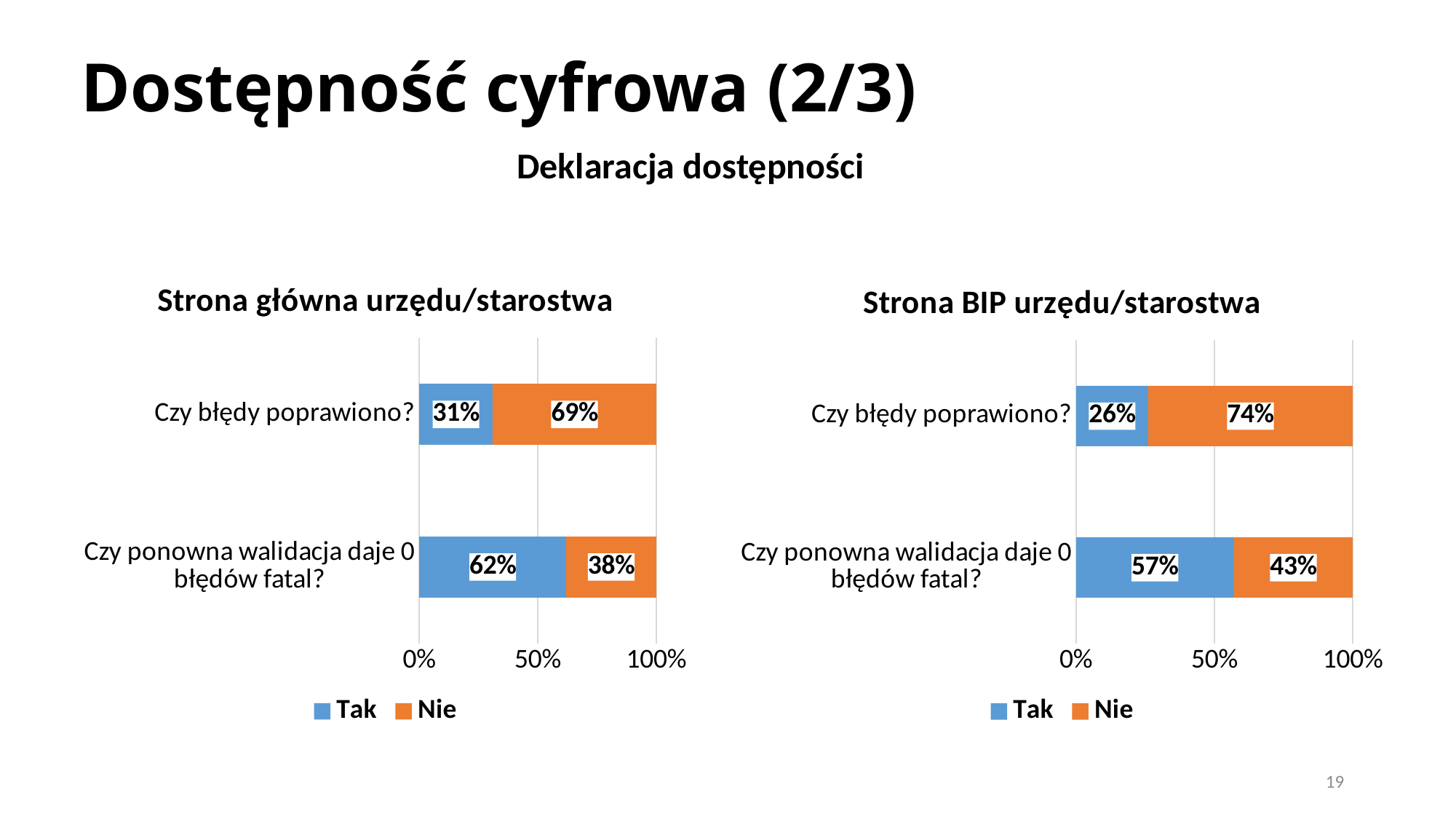
In the 'Strona BIP urzędu/starostwa' chart, what is the difference between the 'Tak' and 'Nie' values for 'Czy ponowna walidacja daje 0 błędów fatal?'? 14% In the 'Strona główna urzędu/starostwa' chart, what is the total of the stacked bar for 'Czy ponowna walidacja daje 0 błędów fatal?'? 100% How many series does the legend of the 'Strona BIP urzędu/starostwa' chart list? 2 In the 'Strona główna urzędu/starostwa' chart, what is the difference between the 'Nie' and 'Tak' values for 'Czy błędy poprawiono?'? 38% What kind of chart is the 'Strona BIP urzędu/starostwa' chart? Stacked bar chart In the 'Strona BIP urzędu/starostwa' chart, what is the 'Tak' value for 'Czy ponowna walidacja daje 0 błędów fatal?'? 57% In the 'Strona główna urzędu/starostwa' chart, what is the 'Tak' value for 'Czy błędy poprawiono?'? 31% In the 'Strona główna urzędu/starostwa' chart, what is the 'Nie' value for 'Czy ponowna walidacja daje 0 błędów fatal?'? 38% In the 'Strona BIP urzędu/starostwa' chart, which category has the higher 'Nie' value? Czy błędy poprawiono? In the 'Strona BIP urzędu/starostwa' chart, what is the 'Nie' value for 'Czy błędy poprawiono?'? 74% How many categories are shown in the 'Strona główna urzędu/starostwa' chart? 2 Which chart has the larger 'Tak' value for 'Czy błędy poprawiono?', 'Strona główna urzędu/starostwa' or 'Strona BIP urzędu/starostwa'? Strona główna urzędu/starostwa